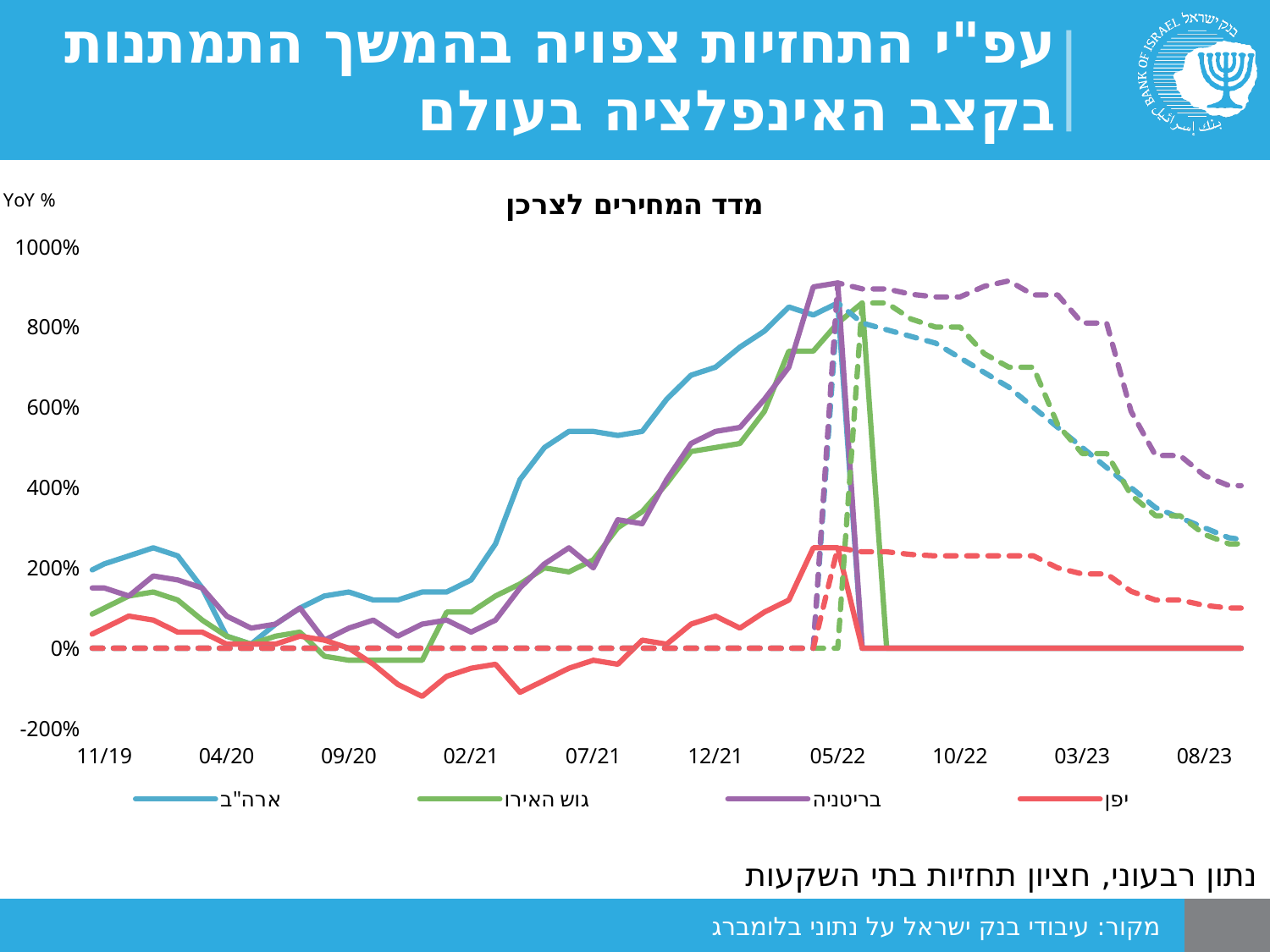
At 11/19, which is larger: the value for ארה"ב or the value for יפן? ארה"ב Is the value for יפן at 08/23 greater or less than 200%? less How many date labels are shown on the x axis? 10 What is the title of the chart? מדד המחירים לצרכן Which series are listed in the chart legend? ארה"ב, גוש האירו, בריטניה, יפן Which series has the highest value at 08/23? בריטניה Is the value for ארה"ב at 05/22 greater or less than 600%? greater What kind of chart is shown on the slide? line chart How many series does the legend list? 4 Does the value for ארה"ב rise or fall between 09/20 and 05/22? rise Which series has the lowest value at 08/23? יפן At 08/23, which is larger: the value for בריטניה or the value for יפן? בריטניה